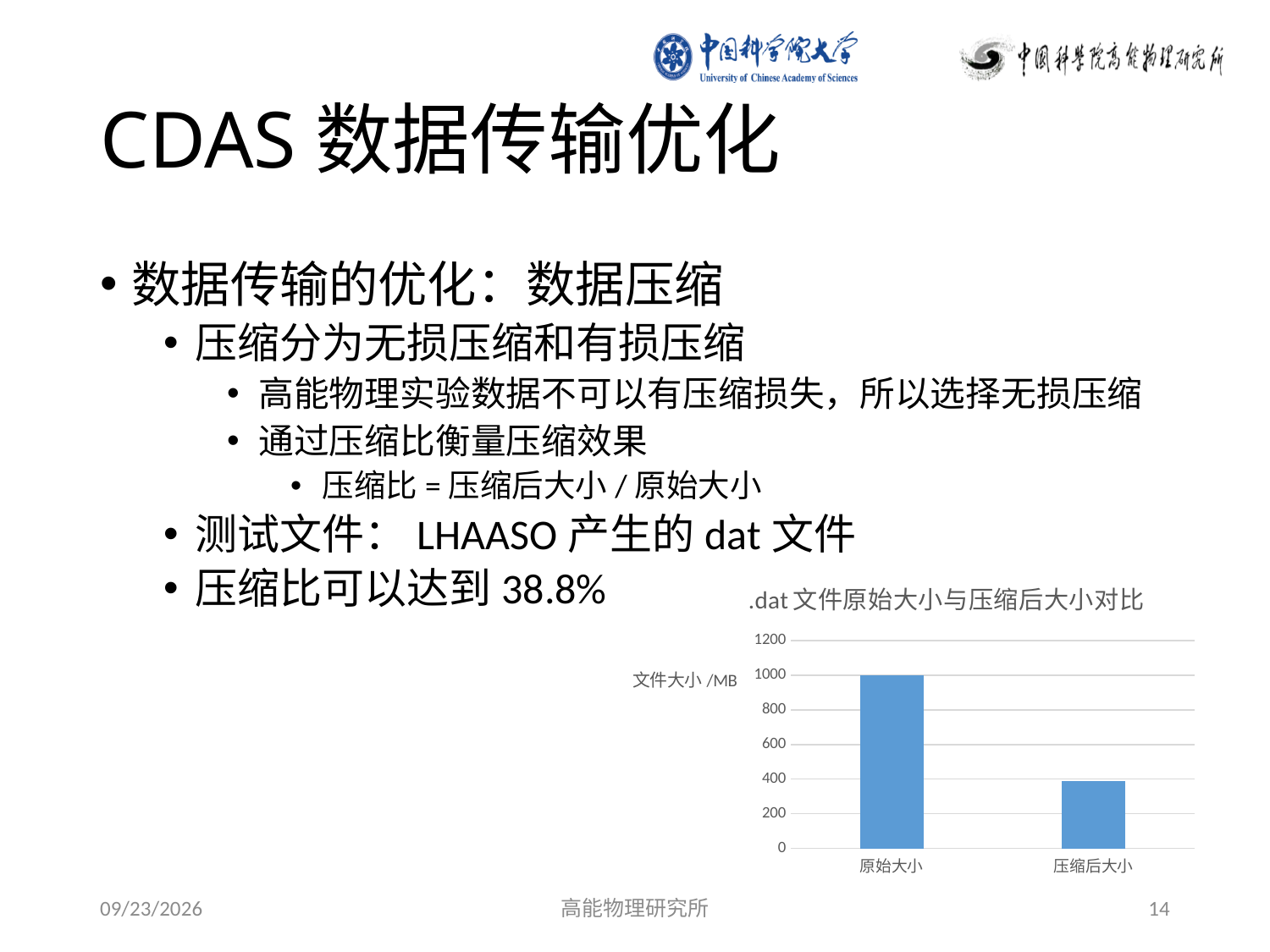
What kind of chart is shown on the slide? bar chart Is the value for 压缩后大小 greater or less than 200? greater What is the title of the chart? .dat 文件原始大小与压缩后大小对比 What is the label of the y axis? 文件大小 /MB What is the value for 原始大小? 1000 Which category has the highest value? 原始大小 Which is larger, 原始大小 or 压缩后大小? 原始大小 Which category has the lowest value? 压缩后大小 How many categories are shown on the x axis? 2 Do the values rise or fall from 原始大小 to 压缩后大小? fall Is the value for 原始大小 greater or less than 800? greater